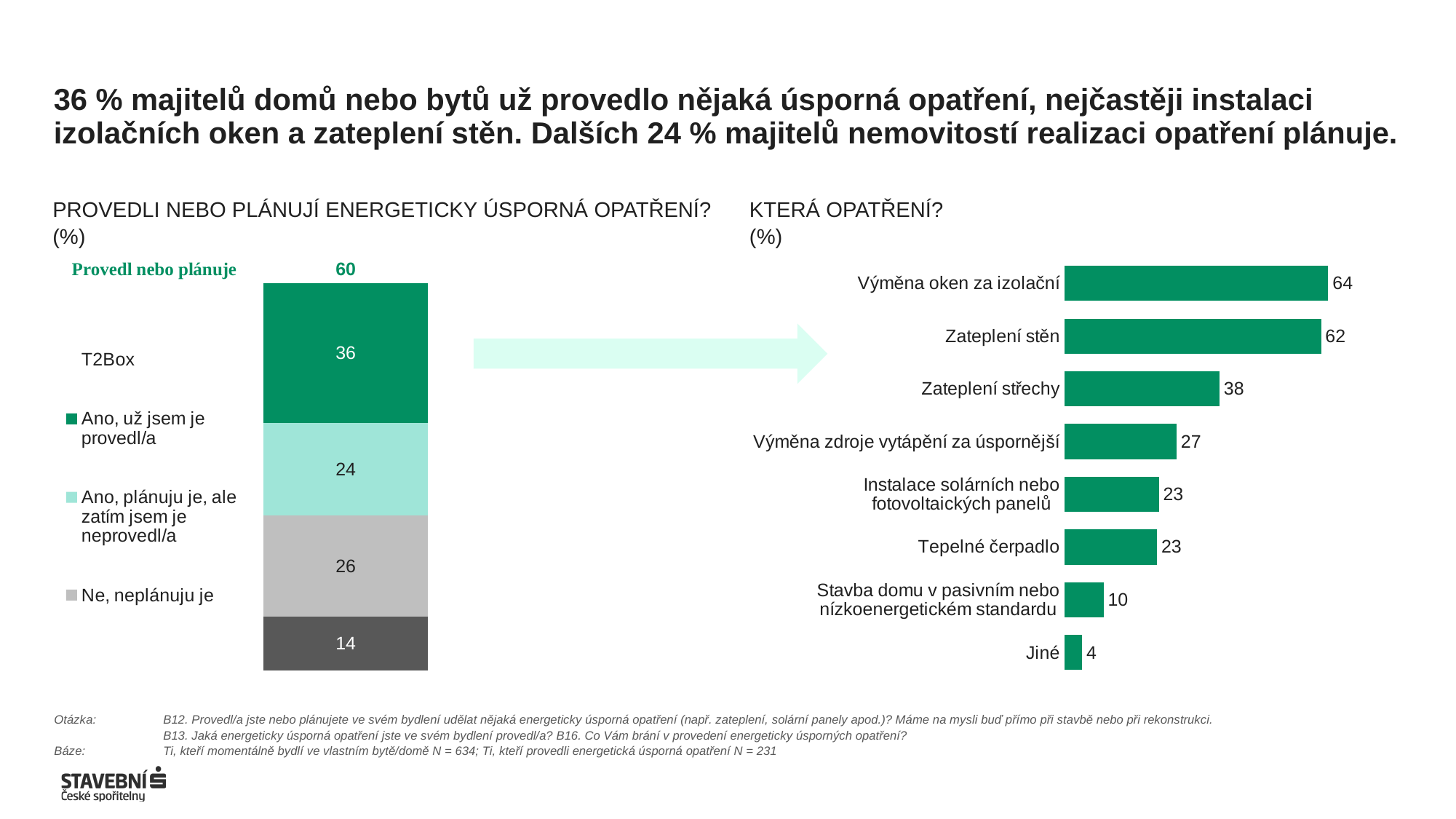
How many categories are shown in the chart "KTERÁ OPATŘENÍ?"? 8 In the chart "PROVEDLI NEBO PLÁNUJÍ ENERGETICKY ÚSPORNÁ OPATŘENÍ?", what is the value for "Ne, neplánuju je"? 26 In the chart "KTERÁ OPATŘENÍ?", what is the difference between "Zateplení stěn" and "Zateplení střechy"? 24 In the chart "KTERÁ OPATŘENÍ?", what is the value for "Zateplení střechy"? 38 How many entries does the legend of the chart "PROVEDLI NEBO PLÁNUJÍ ENERGETICKY ÚSPORNÁ OPATŘENÍ?" list? 3 In the chart "KTERÁ OPATŘENÍ?", what is the value for "Výměna oken za izolační"? 64 In the chart "KTERÁ OPATŘENÍ?", which category has the lowest value? Jiné What kind of chart is "KTERÁ OPATŘENÍ?"? Bar chart In the chart "PROVEDLI NEBO PLÁNUJÍ ENERGETICKY ÚSPORNÁ OPATŘENÍ?", what is the value for "Ano, už jsem je provedl/a"? 36 In the chart "KTERÁ OPATŘENÍ?", which is larger: "Výměna zdroje vytápění za úspornější" or "Tepelné čerpadlo"? Výměna zdroje vytápění za úspornější In the chart "PROVEDLI NEBO PLÁNUJÍ ENERGETICKY ÚSPORNÁ OPATŘENÍ?", what is the T2Box value labelled "Provedl nebo plánuje"? 60 In the chart "KTERÁ OPATŘENÍ?", which category has the highest value? Výměna oken za izolační